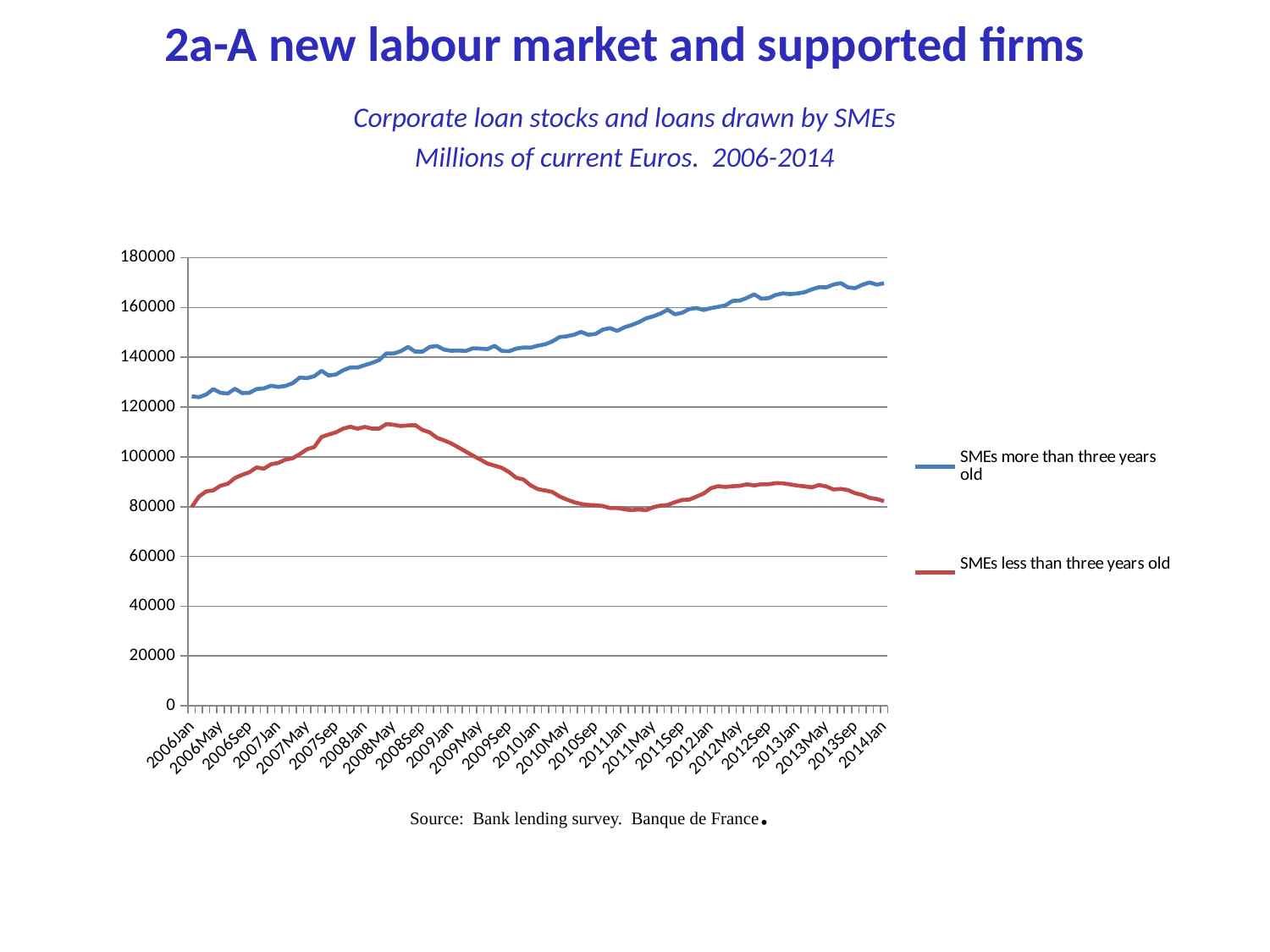
What kind of chart is shown on the slide? line chart At 2010Jan, which series has the higher value: SMEs more than three years old or SMEs less than three years old? SMEs more than three years old Is the value for SMEs more than three years old at 2006Jan greater or less than 140000? less Is the value for SMEs less than three years old at 2008May greater or less than 100000? greater Is the value for SMEs more than three years old at 2014Jan greater or less than 160000? greater Does the line for SMEs more than three years old generally rise or fall from 2006Jan to 2014Jan? rise Does the line for SMEs less than three years old rise or fall between 2008Sep and 2011Jan? fall What is the highest value shown on the vertical axis? 180000 What are the two series named in the legend? SMEs more than three years old; SMEs less than three years old What is the chart's title as shown on the slide? Corporate loan stocks and loans drawn by SMEs Millions of current Euros. 2006-2014 How many series does the legend list? 2